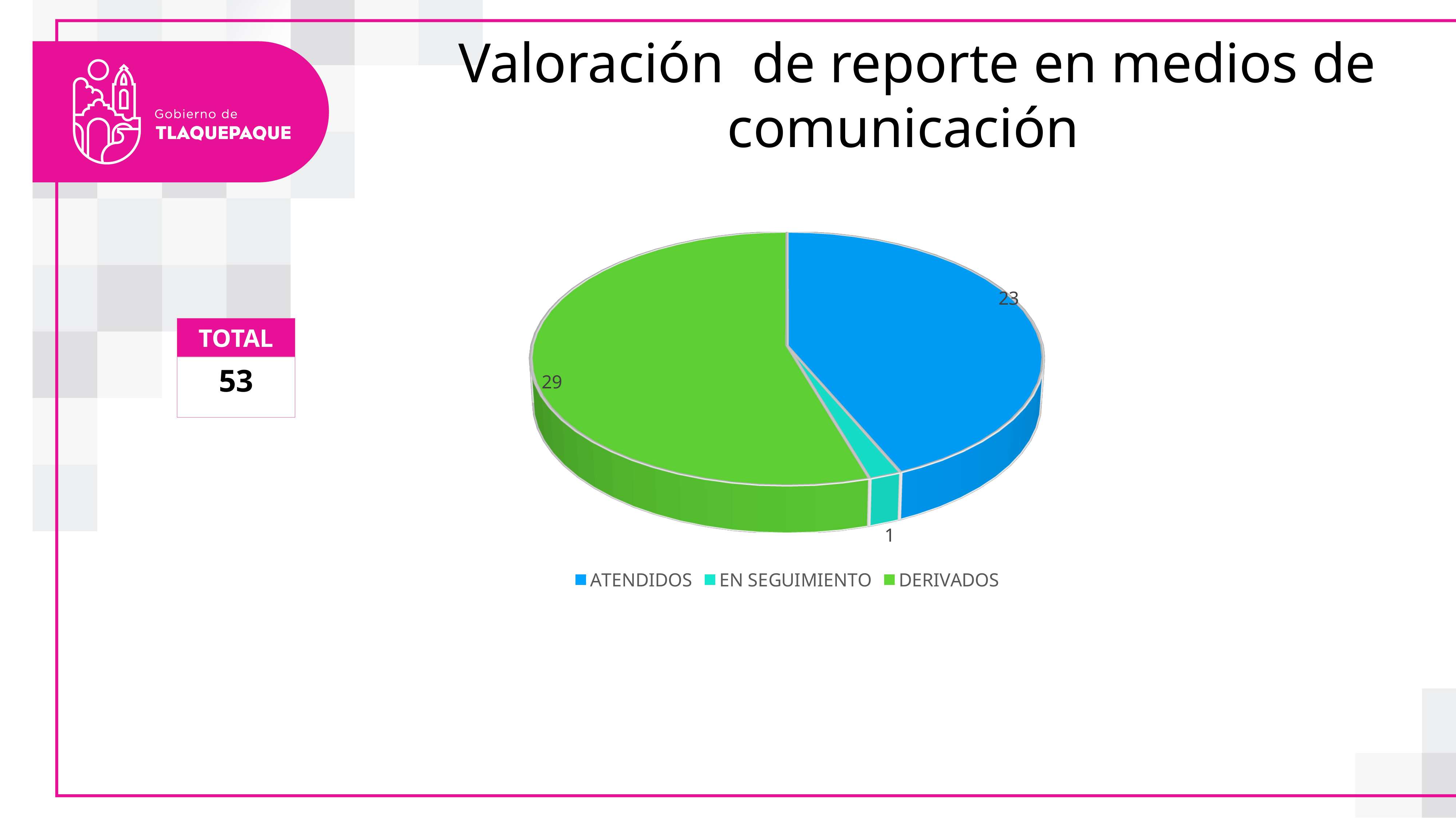
Which is larger, ATENDIDOS or EN SEGUIMIENTO? ATENDIDOS Which category has the smallest slice? EN SEGUIMIENTO What is the value for DERIVADOS? 29 What colour is the DERIVADOS slice? Green What is the value for ATENDIDOS? 23 What is the title of the chart? Valoración de reporte en medios de comunicación What is the total of all slices in the pie chart? 53 What is the difference between the values for DERIVADOS and ATENDIDOS? 6 Which category has the largest slice? DERIVADOS How many slices does the pie chart have? 3 What is the value for EN SEGUIMIENTO? 1 What type of chart is shown on the slide? Pie chart